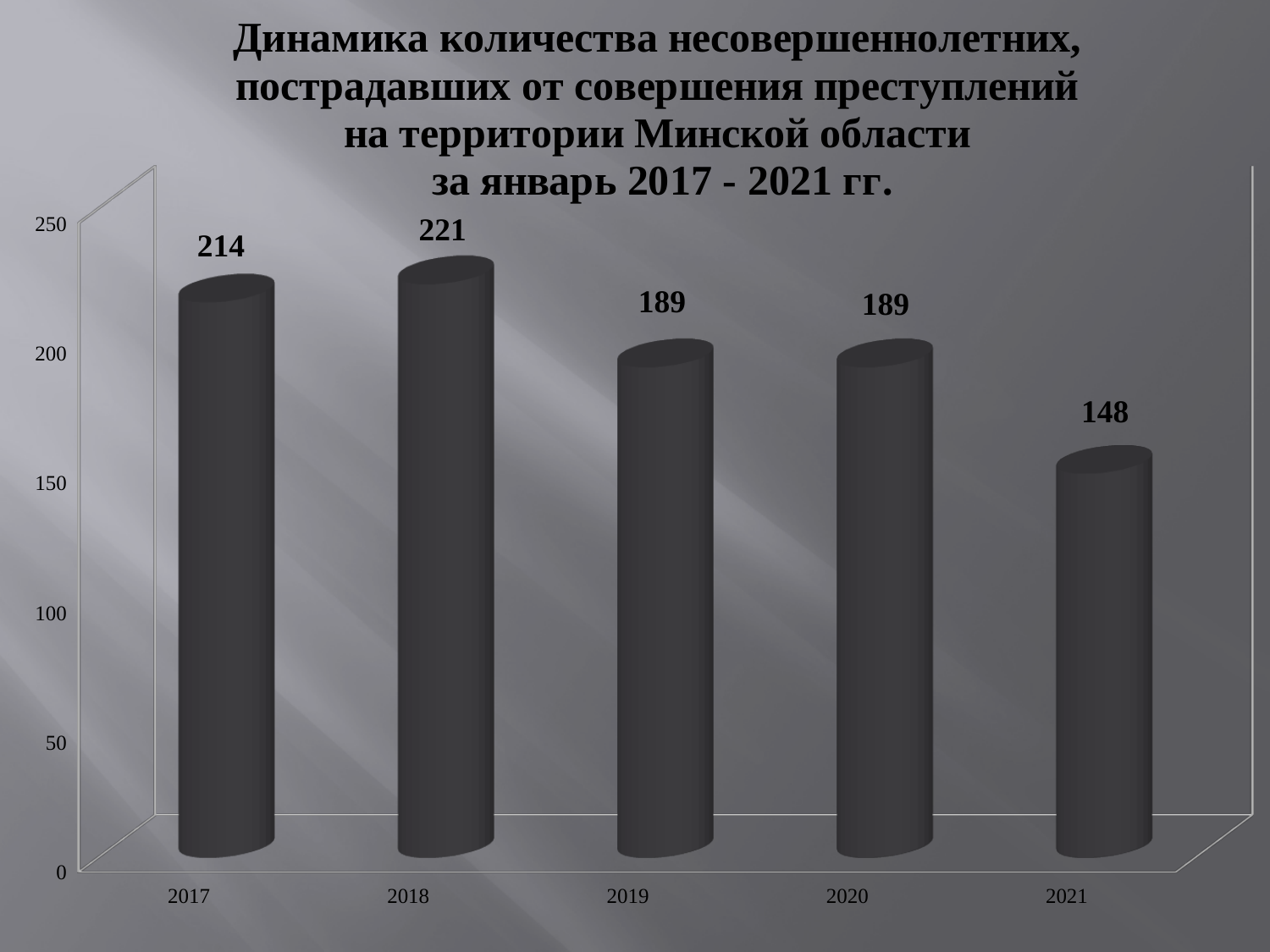
What is the value for 2021? 148 What kind of chart is shown on the slide? bar chart How many years are shown on the chart? 5 Do the values generally rise or fall from 2018 to 2021? fall Which is larger, the value for 2017 or the value for 2020? 2017 Which year has the highest value? 2018 Which year has the lowest value? 2021 What is the difference between the values for 2018 and 2021? 73 What is the value for 2019? 189 What is the difference between the values for 2017 and 2019? 25 What is the value for 2017? 214 Is the value for 2021 greater or less than 150? less